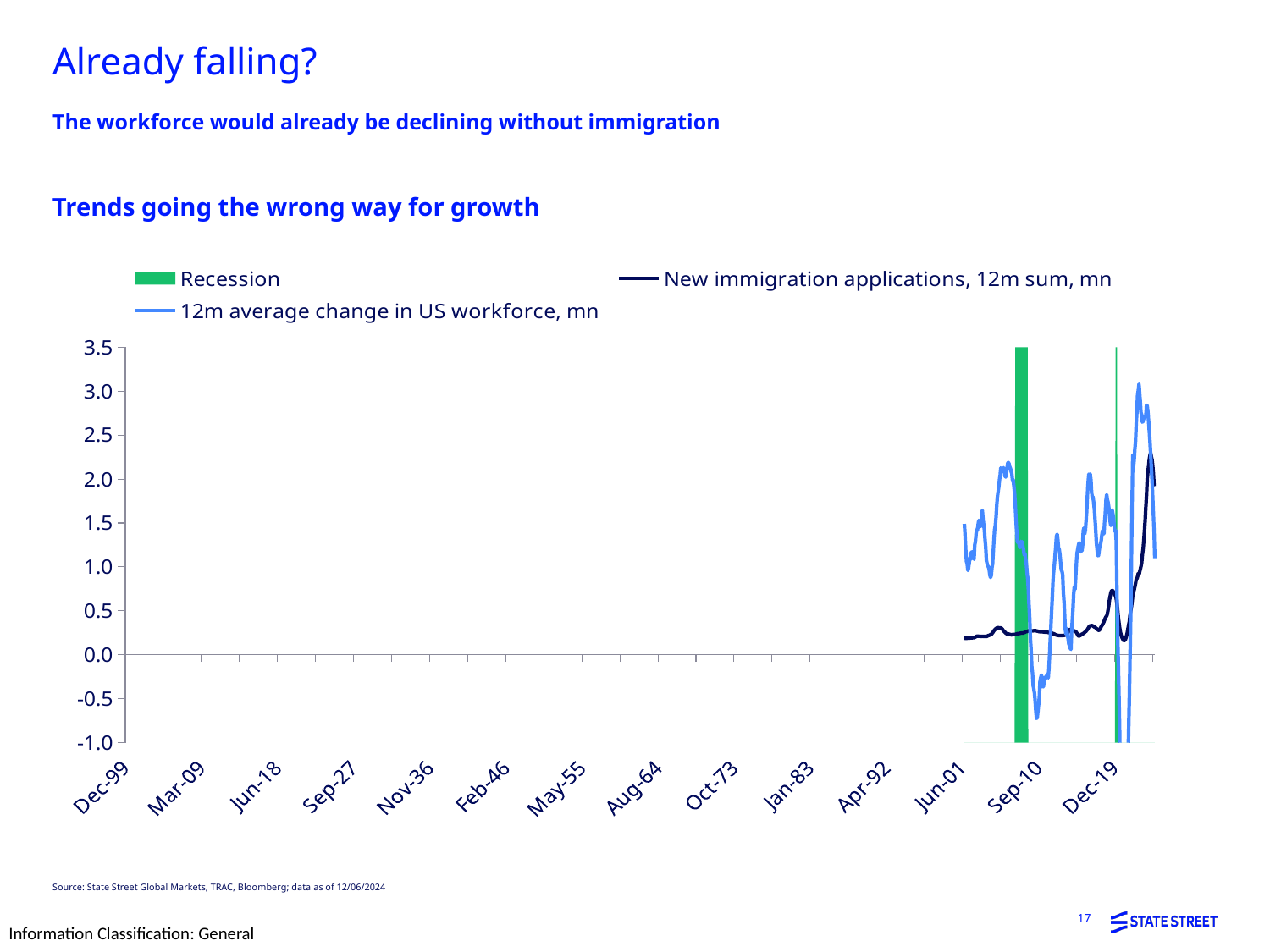
What colour is the Recession shading in the chart? green How many date labels are shown on the x axis? 14 Is the peak value of the 'New immigration applications, 12m sum, mn' line greater or less than 2.0? greater How many entries does the chart legend list? 3 At the start of its data, is the 'New immigration applications, 12m sum, mn' line greater or less than 0.5? less Is the peak value of the '12m average change in US workforce, mn' line greater or less than 2.5? greater What is the highest value shown on the y axis? 3.5 What kind of chart is shown on the slide? line chart Does the 'New immigration applications, 12m sum, mn' line generally rise or fall from the start of its data to its peak near the end? rise What is the title of the chart? Trends going the wrong way for growth At the start of the plotted data, which line is higher: '12m average change in US workforce, mn' or 'New immigration applications, 12m sum, mn'? 12m average change in US workforce, mn